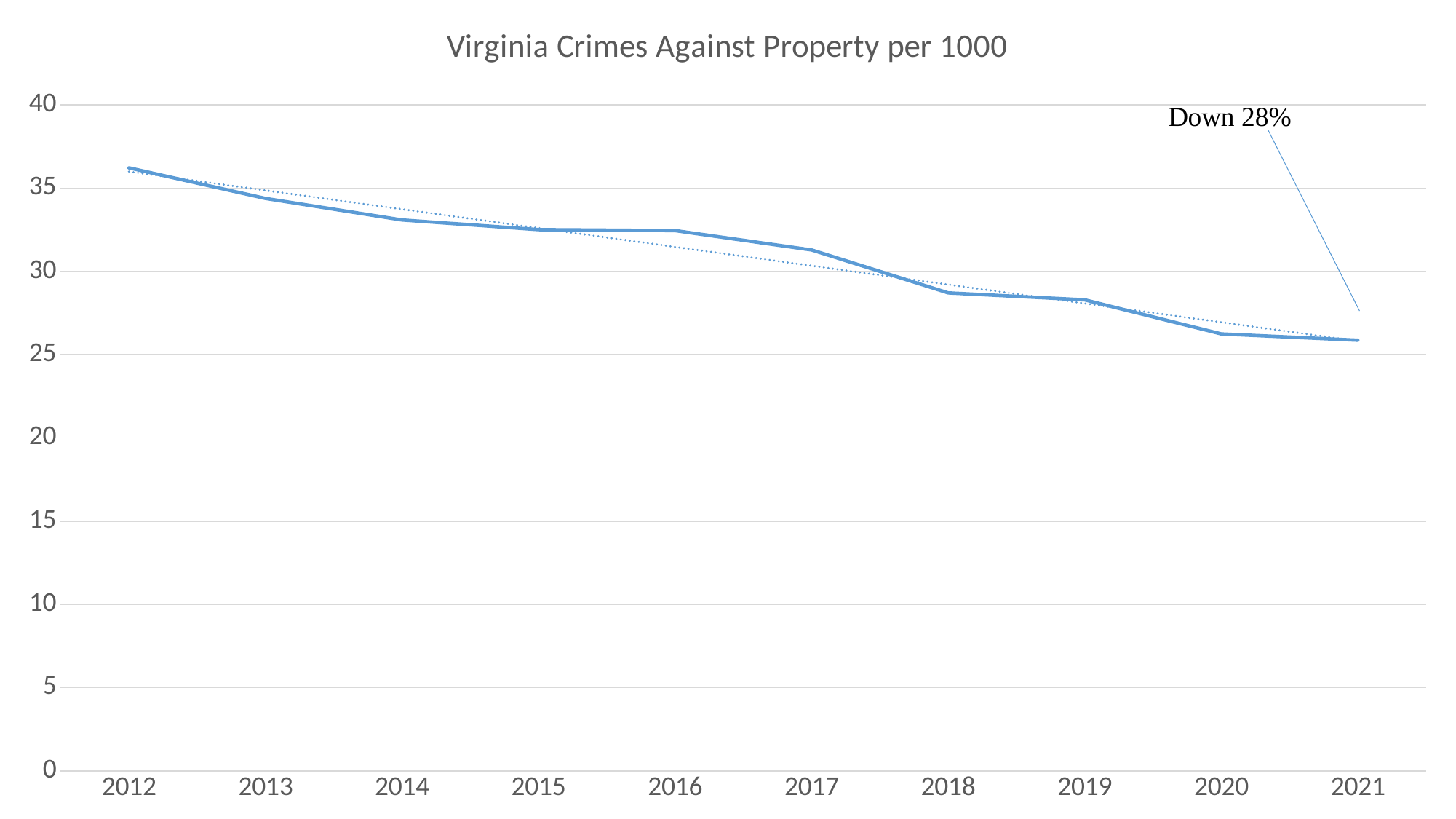
What kind of chart is shown on the slide? line chart Is the value for 2012 greater or less than 35? greater What is the title of the chart? Virginia Crimes Against Property per 1000 Which year has the highest value? 2012 How many years are plotted along the x axis? 10 Which year has the larger value, 2014 or 2020? 2014 Is the value for 2016 greater or less than 30? greater Do the values rise or fall from 2012 to 2021? fall Which year has the lowest value? 2021 Is the value for 2018 greater or less than 30? less What percentage decline does the annotation on the chart state? Down 28%